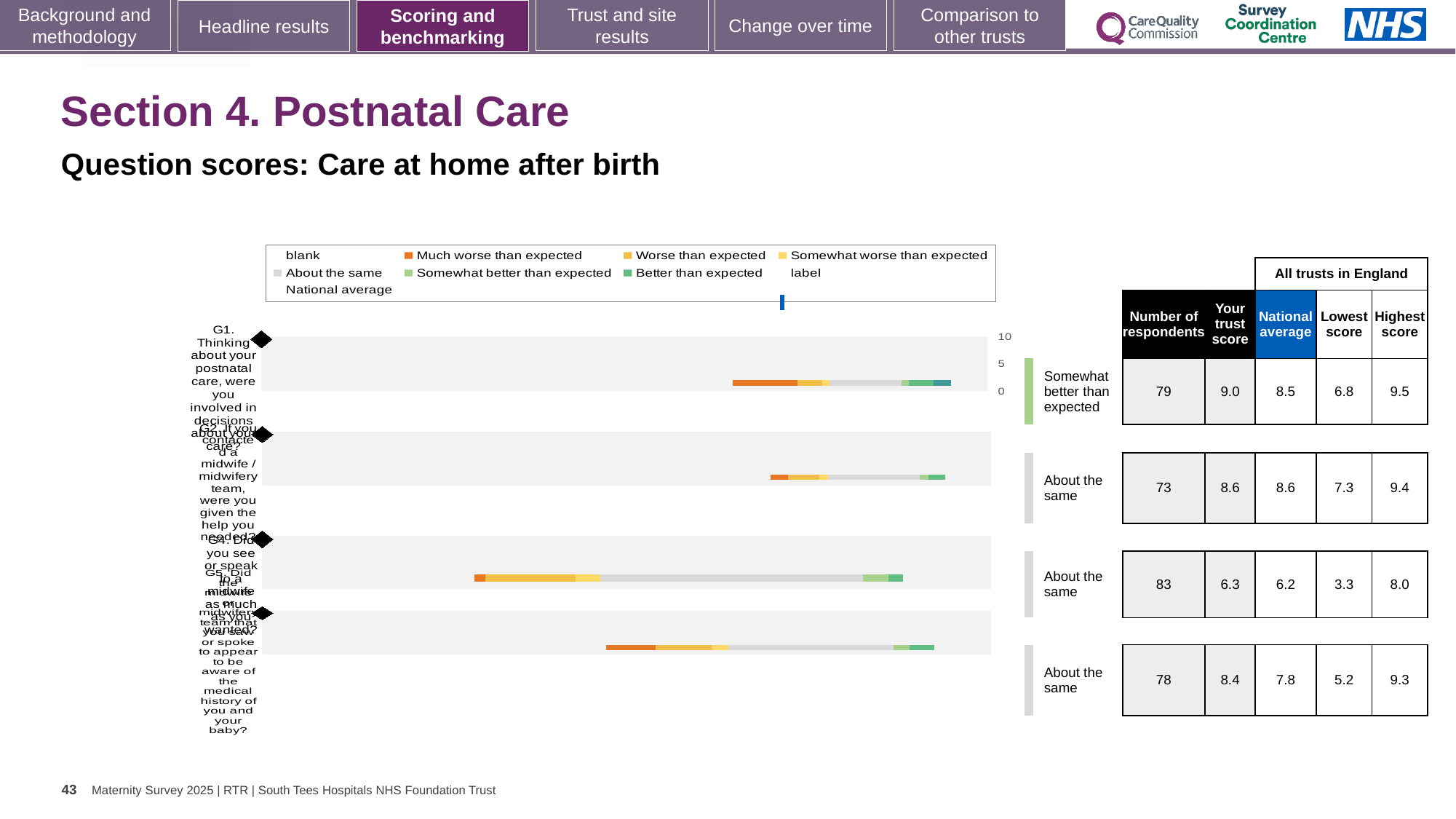
Which question row has the highest number of respondents? the third row (83) What is the lowest score for the third question row in the table? 3.3 What kind of chart is shown on the slide? bar chart What is the trust score for the first (top) question row in the table? 9.0 What is the national average for the second question row in the table? 8.6 What benchmark label is shown next to the first (top) question row? Somewhat better than expected In the table beside the chart, what is the number of respondents for the first (top) question row? 79 What colour does the legend use for 'Much worse than expected'? orange What is the highest score for the fourth (bottom) question row in the table? 9.3 For the third question row, what is the difference between the highest score and the lowest score? 4.7 For the first (top) question row, which is larger: the trust score or the national average? trust score How many question bars are plotted in the chart? 4